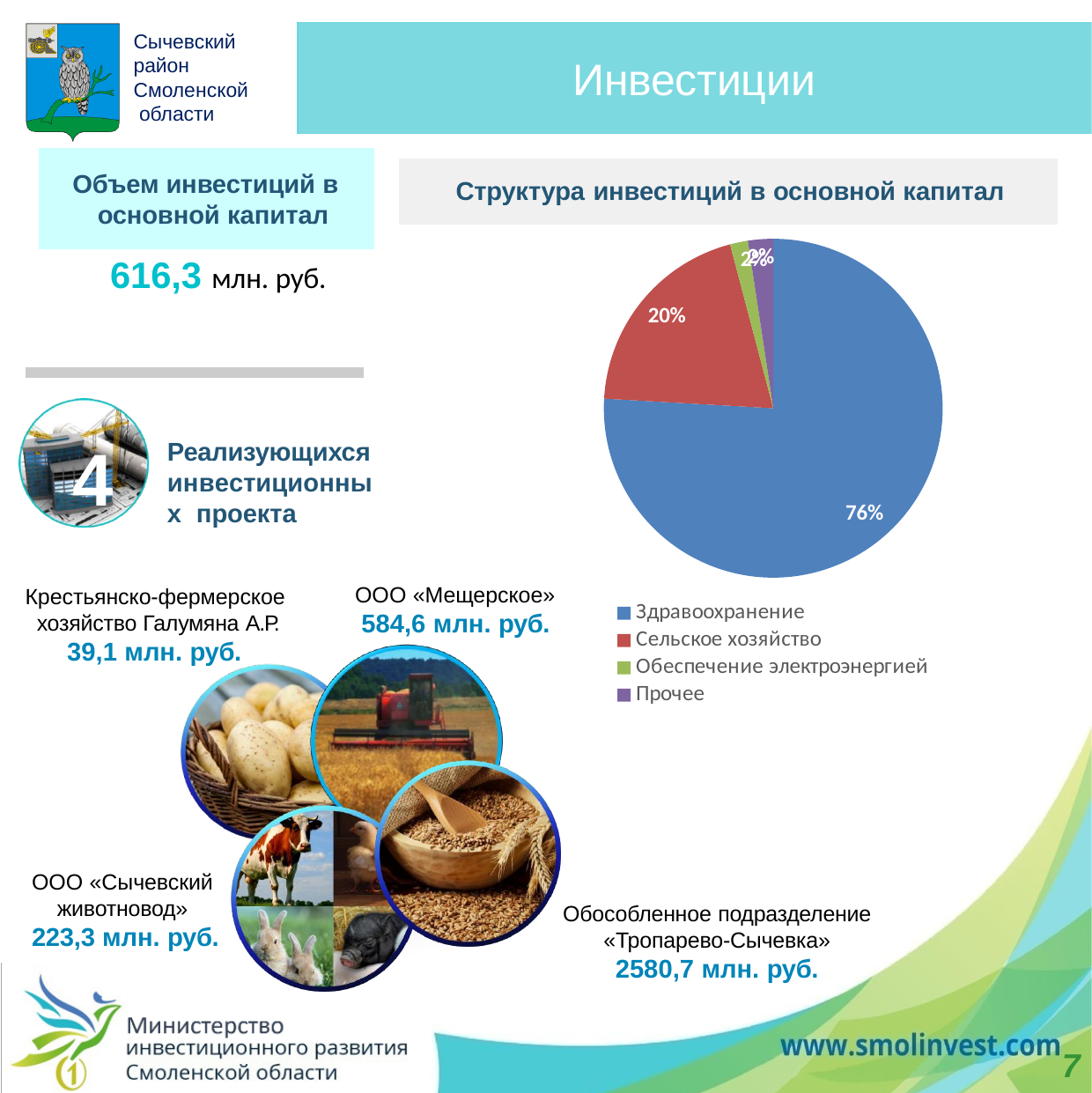
By how many percentage points does «Здравоохранение» exceed «Сельское хозяйство» in the pie chart? 56 What colour is the «Здравоохранение» slice in the pie chart? blue Which is larger in the pie chart: «Сельское хозяйство» or «Здравоохранение»? Здравоохранение What share of the pie chart does «Сельское хозяйство» account for? 20% Which is larger in the pie chart: «Обеспечение электроэнергией» or «Сельское хозяйство»? Сельское хозяйство How many categories does the pie chart legend list? 4 What share of the pie chart does «Здравоохранение» account for? 76% What is the title of the pie chart? Структура инвестиций в основной капитал Is the share for «Сельское хозяйство» greater or less than 50%? less Which category has the largest slice in the pie chart? Здравоохранение What kind of chart is shown under the title «Структура инвестиций в основной капитал»? pie chart